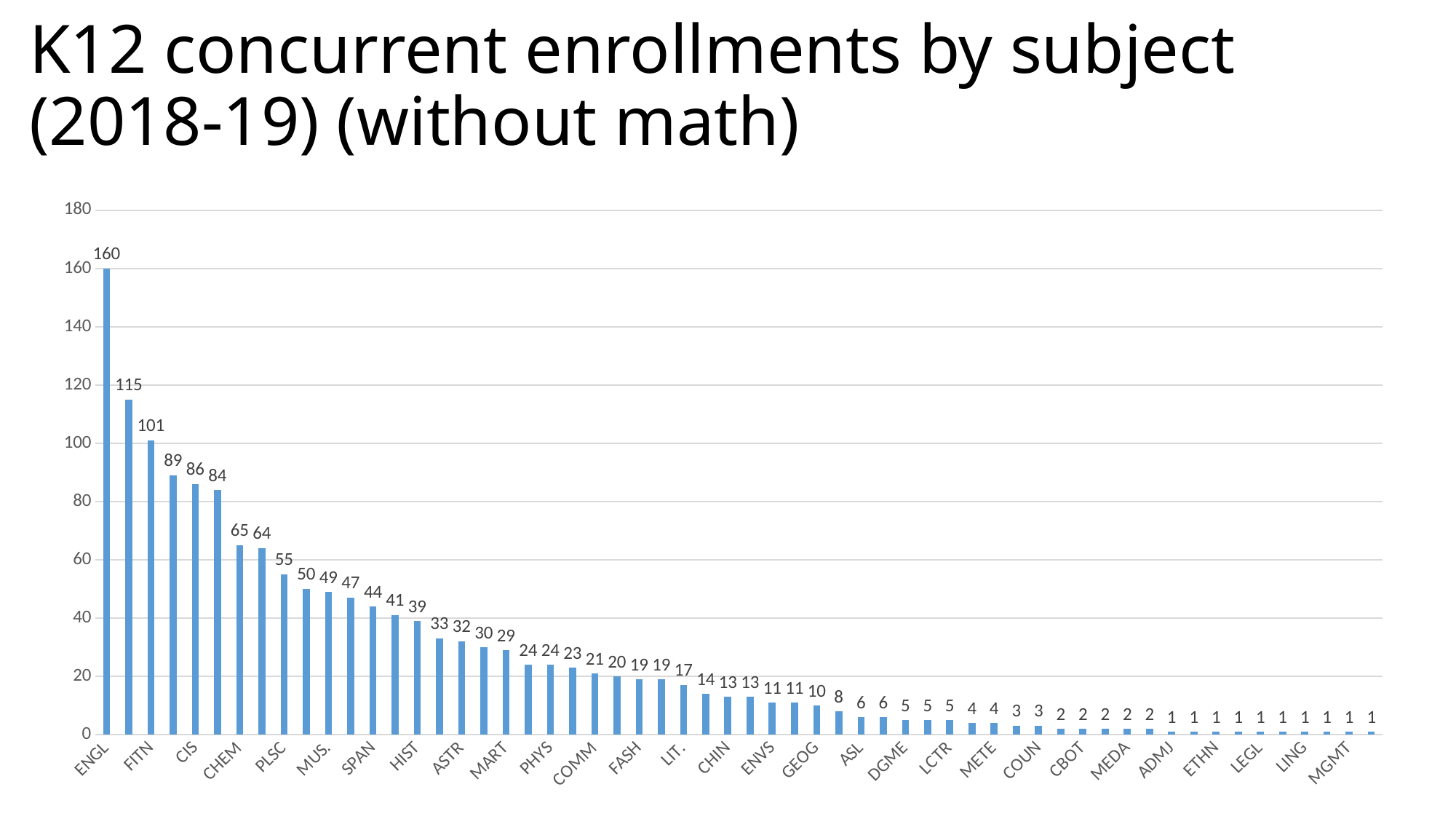
What type of chart is shown on the slide? bar chart How many K12 concurrent enrollments does CHEM have? 65 What is the difference in enrollments between ENGL and FITN? 59 Which has more enrollments, CHEM or SPAN? CHEM Do the values rise or fall moving from left to right along the x axis? fall How many K12 concurrent enrollments does ENGL have? 160 How many K12 concurrent enrollments does FITN have? 101 What is the title of the chart on the slide? K12 concurrent enrollments by subject (2018-19) (without math) Which subject has the highest number of K12 concurrent enrollments? ENGL Is the value for ENGL greater or less than 140? greater Is the value for HIST greater or less than 60? less How many K12 concurrent enrollments does PLSC have? 55